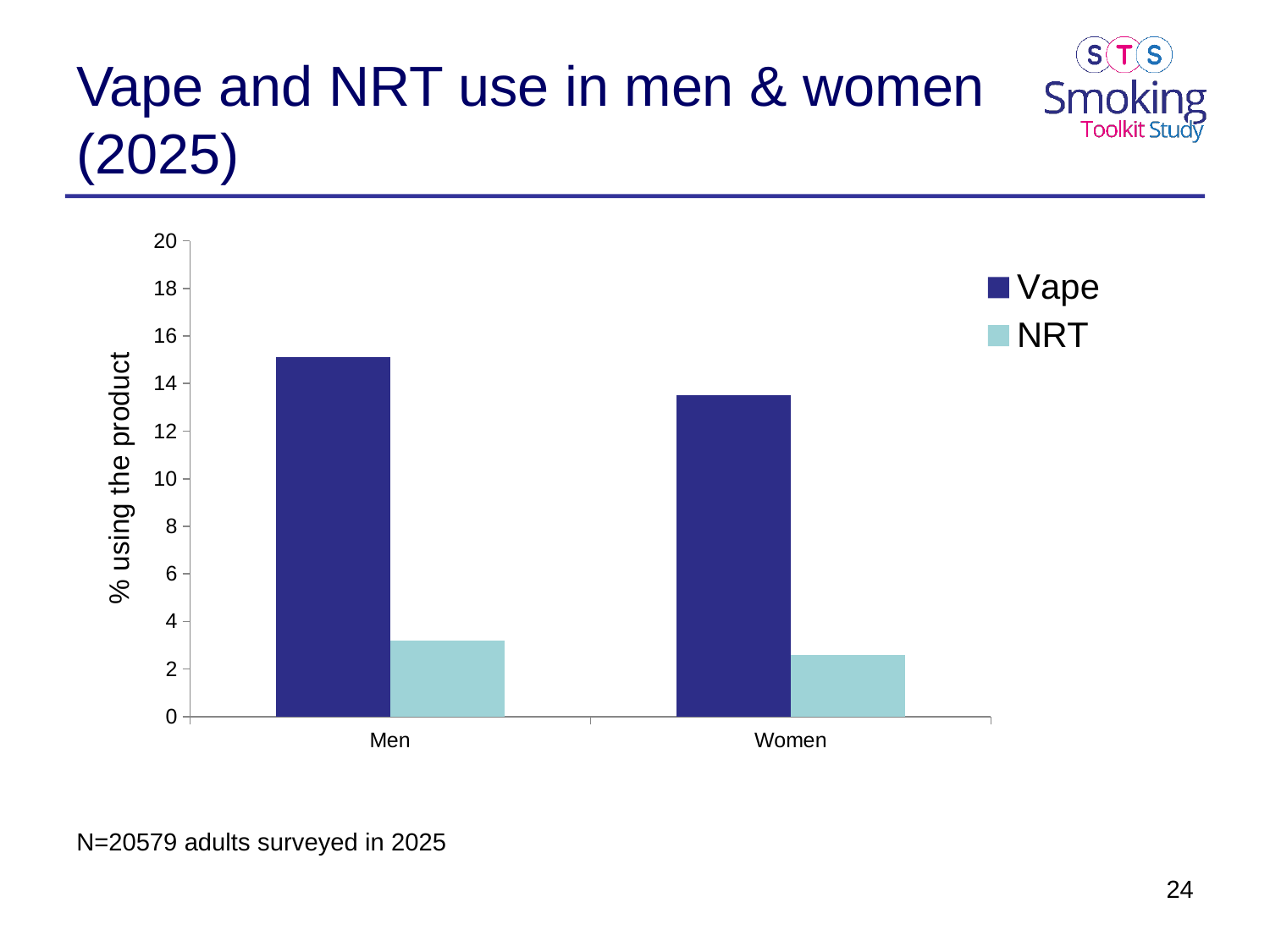
How many series does the legend list? 2 How many categories are shown on the x axis? 2 Is the Vape value for Men greater or less than 14? greater What is the label on the y axis? % using the product What kind of chart is shown on the slide? bar chart For Men, which is larger, the Vape value or the NRT value? Vape Is the NRT value for Women greater or less than 4? less Is the NRT value for Men greater or less than 2? greater Which series is shown in dark blue? Vape Which group has the higher Vape value, Men or Women? Men